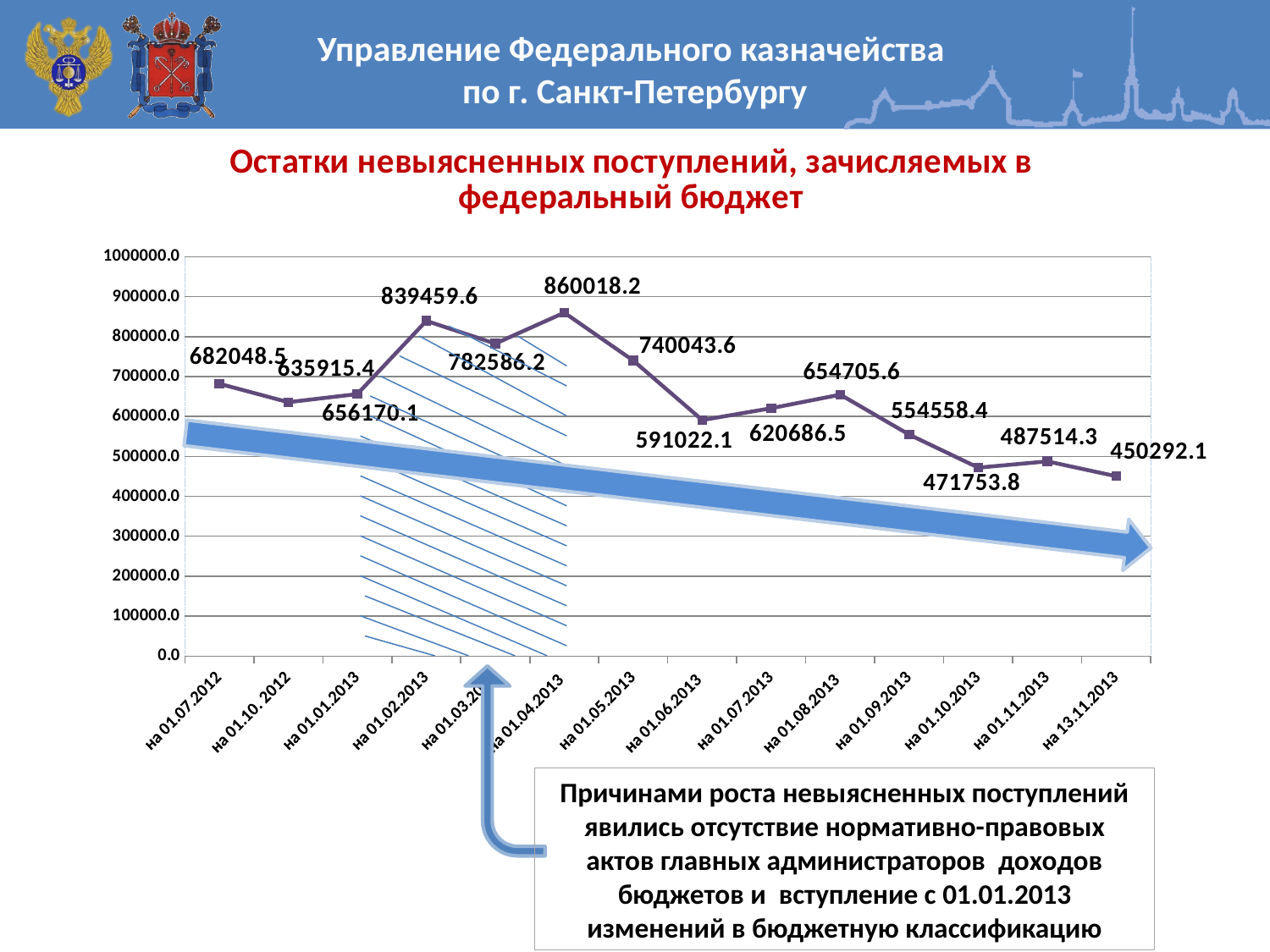
Which date has the lowest value? на 13.11.2013 What is the title of the chart? Остатки невыясненных поступлений, зачисляемых в федеральный бюджет What is the value for на 01.04.2013? 860018.2 How many data points are plotted on the chart? 14 What is the difference between the values for на 01.02.2013 and на 01.01.2013? 183289.5 What kind of chart is shown on the slide? line chart What is the value for на 13.11.2013? 450292.1 Which date has the highest value? на 01.04.2013 Is the value for на 01.10.2013 greater or less than 500000.0? less What is the value for на 01.08.2013? 654705.6 What is the value for на 01.07.2012? 682048.5 Which is larger, the value for на 01.05.2013 or the value for на 01.06.2013? на 01.05.2013